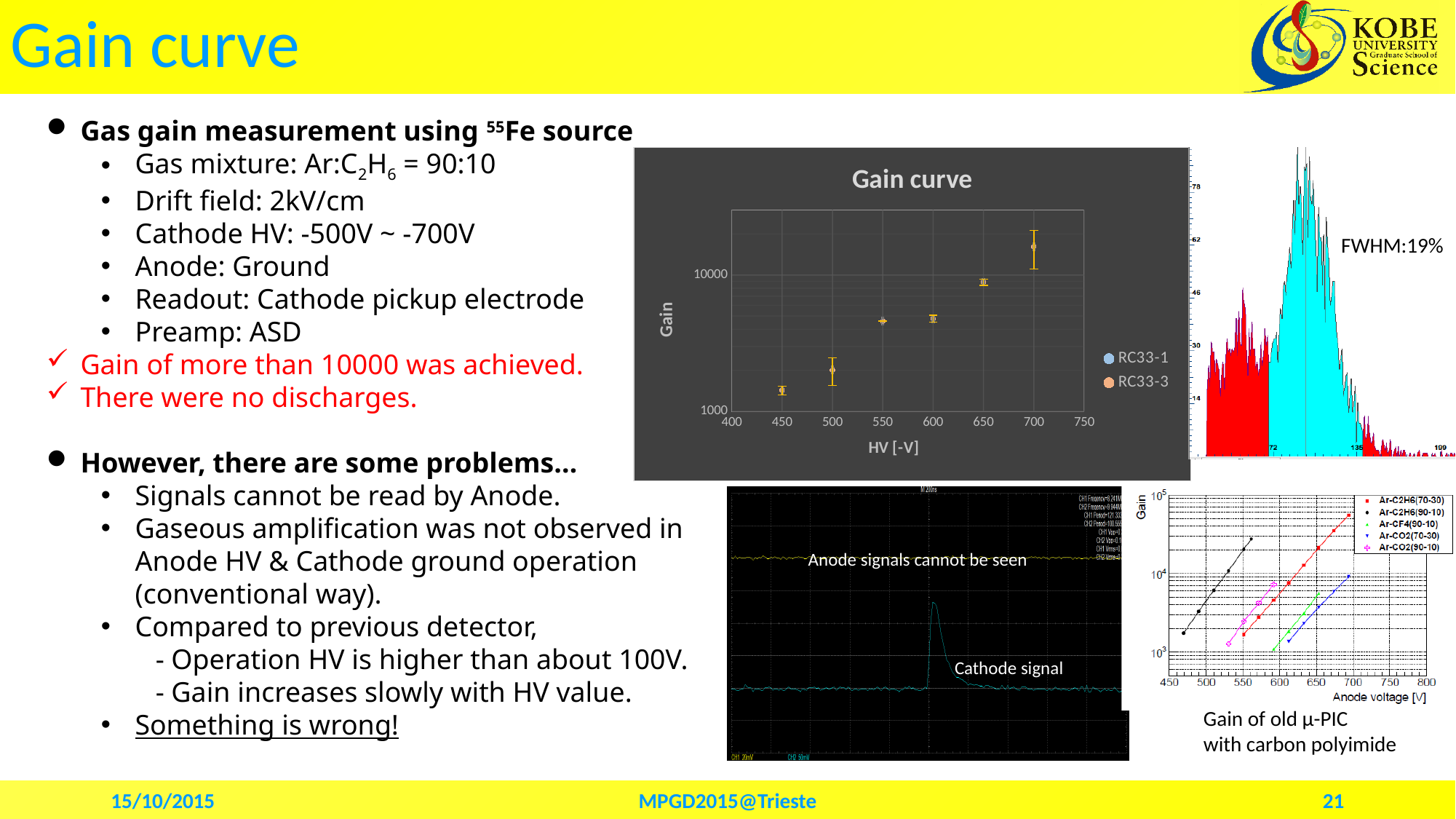
In the 'Gain curve' chart, how many series does the legend list? 2 In the 'Gain curve' chart, at which HV value is the gain lowest? 450 In the 'Gain curve' chart, what kind of chart is it? scatter chart In the 'Gain curve' chart, does the gain rise or fall as HV increases along the x axis? rise In the 'Gain curve' chart, which has the larger gain: HV 550 or HV 650? 650 In the 'Gain curve' chart, is the gain at HV 700 greater or less than 10000? greater In the 'Gain curve' chart, at which HV value is the gain highest? 700 In the 'Gain curve' chart, what is the x-axis title? HV [-V] In the 'Gain of old μ-PIC with carbon polyimide' chart at the bottom right, what is the x-axis title? Anode voltage [V] In the 'Gain of old μ-PIC with carbon polyimide' chart at the bottom right, how many series does the legend list? 5 In the 'Gain curve' chart, is the gain at HV 450 greater or less than 10000? less In the 'Gain curve' chart, how many data points are plotted? 6